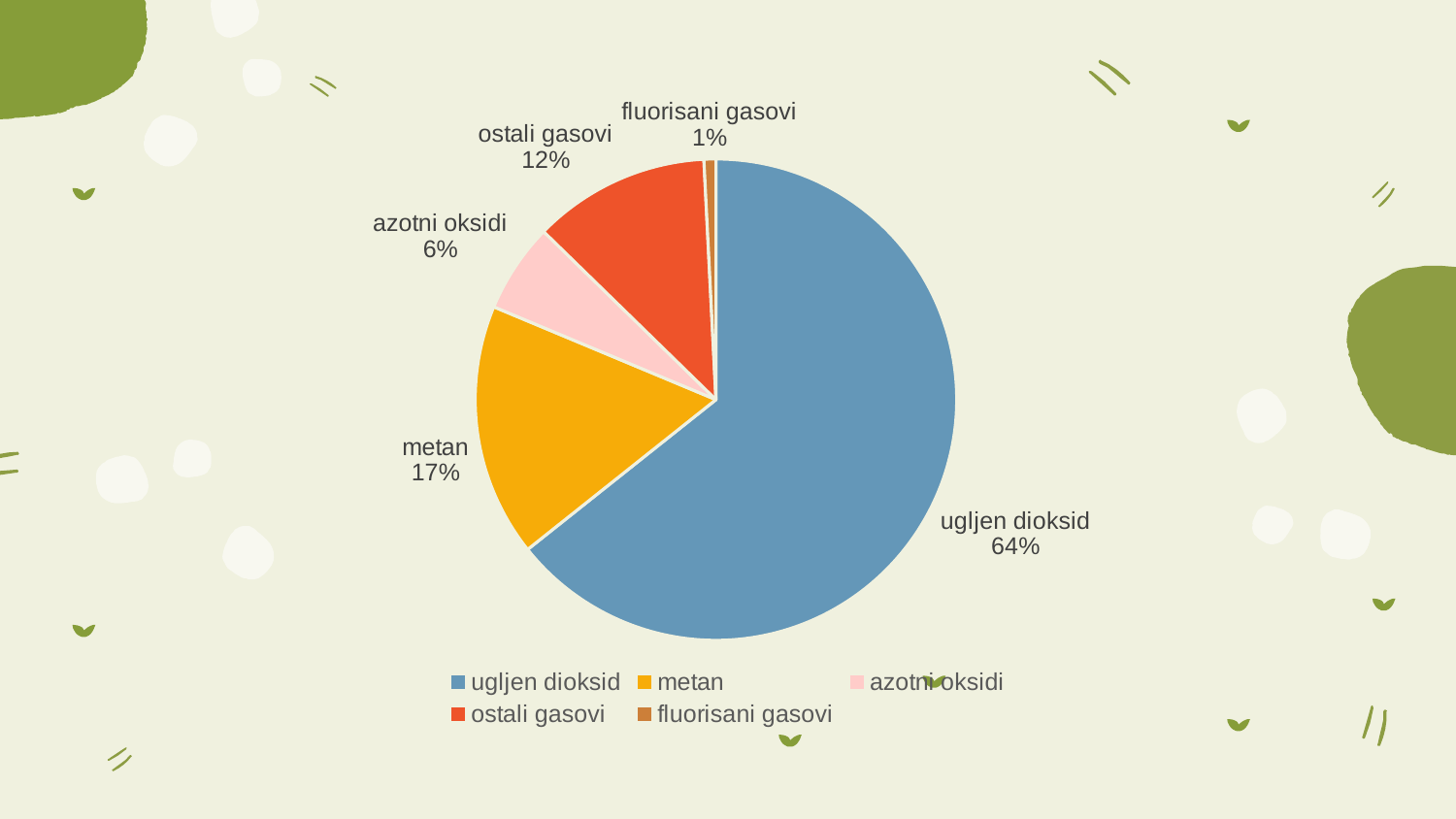
How many slices does the pie chart have? 5 Which category has the smallest slice of the pie? fluorisani gasovi What colour is the slice for metan? yellow What share of the pie does fluorisani gasovi have? 1% Which category has the largest slice of the pie? ugljen dioksid What share of the pie does metan have? 17% What share of the pie does azotni oksidi have? 6% Which is larger, the slice for metan or the slice for ostali gasovi? metan What is the difference in percentage points between ugljen dioksid and metan? 47 What kind of chart is shown on the slide? pie chart